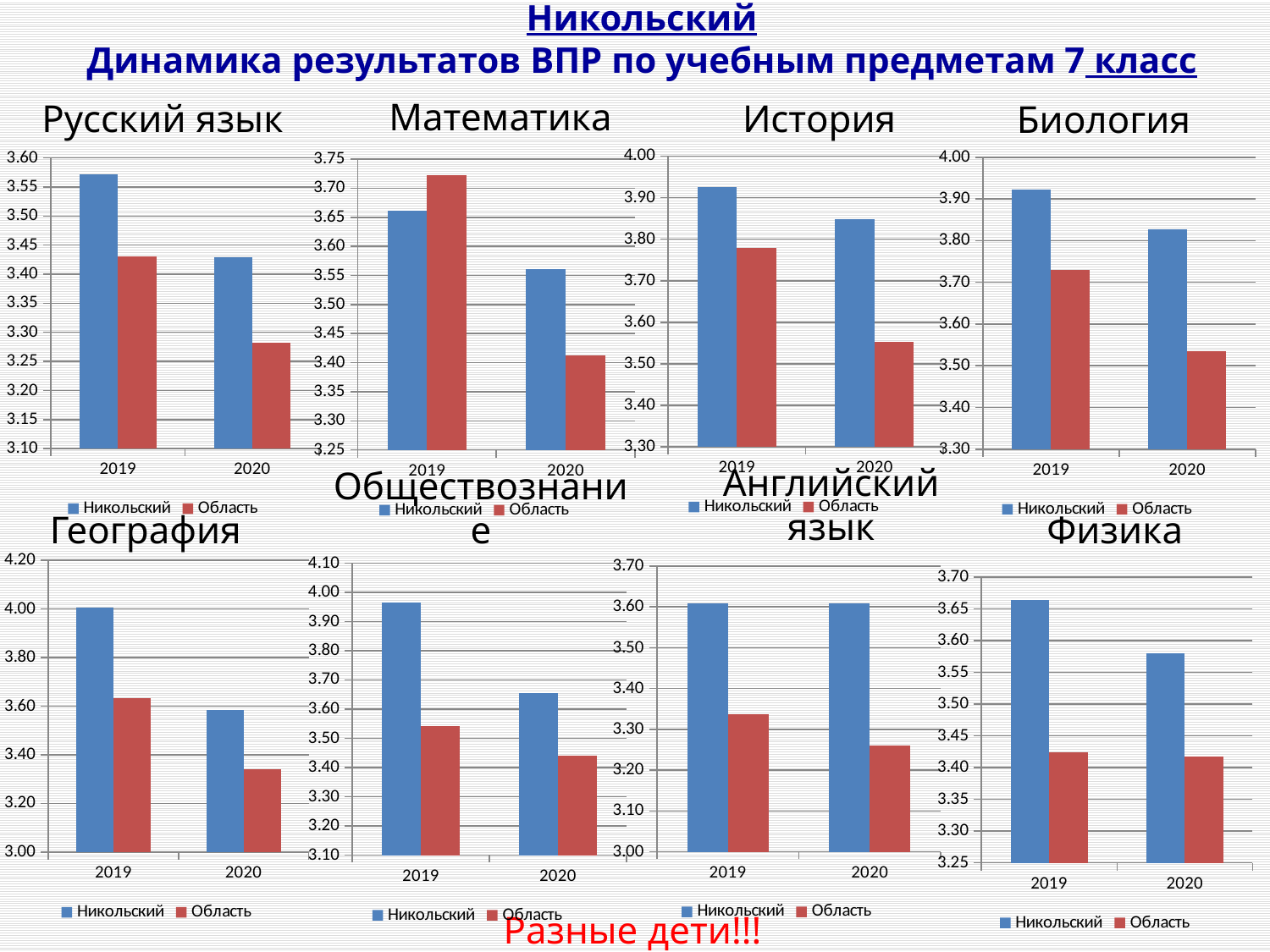
In the История chart, is the value for Область in 2020 greater or less than 3.60? less What kind of chart is the География chart? bar chart In the Физика chart, is the value for Область in 2020 greater or less than 3.50? less In the Обществознание chart, is the value for Никольский in 2019 greater or less than 3.90? greater In the Математика chart, which bar is taller for 2019, Никольский or Область? Область In the Английский язык chart, what colour represents the Область series? red How many series does the legend of the История chart list? 2 In the Русский язык chart, does the value for Никольский rise or fall from 2019 to 2020? fall How many categories are shown on the x axis of the Физика chart? 2